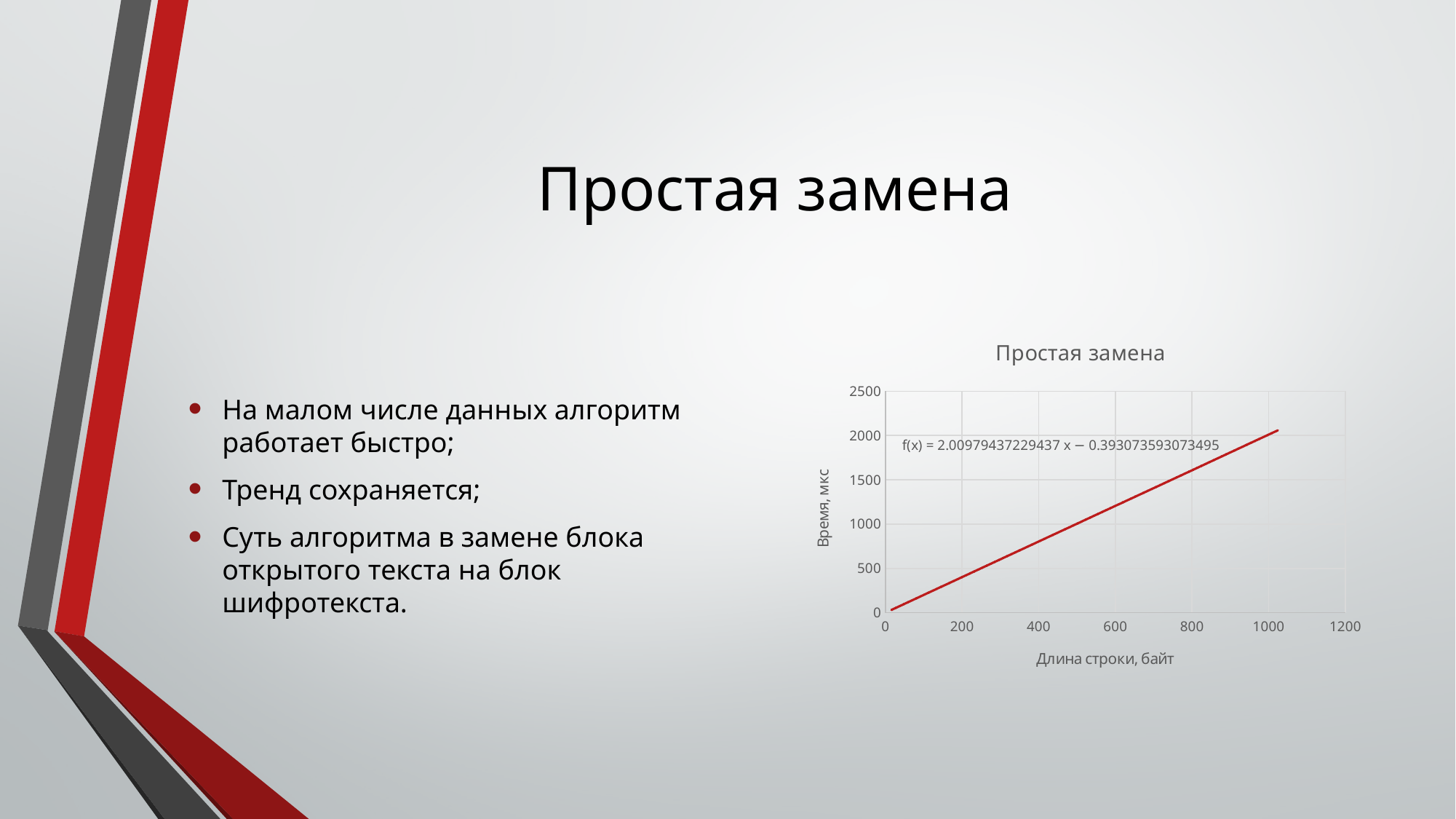
What is the label of the x axis of the chart? Длина строки, байт What is the slope coefficient in the trendline equation printed on the chart? 2.00979437229437 Is the value for a string length of 600 bytes greater or less than 1000? greater What is the highest tick value shown on the x axis of the chart? 1200 What is the highest tick value shown on the y axis of the chart? 2500 Is the value for a string length of 400 bytes greater or less than 1000? less What is the title of the chart? Простая замена Is the value for a string length of 1000 bytes greater or less than 1500? greater What kind of chart is shown on the slide? line chart Do the values on the chart rise or fall as the string length increases along the x axis? rise